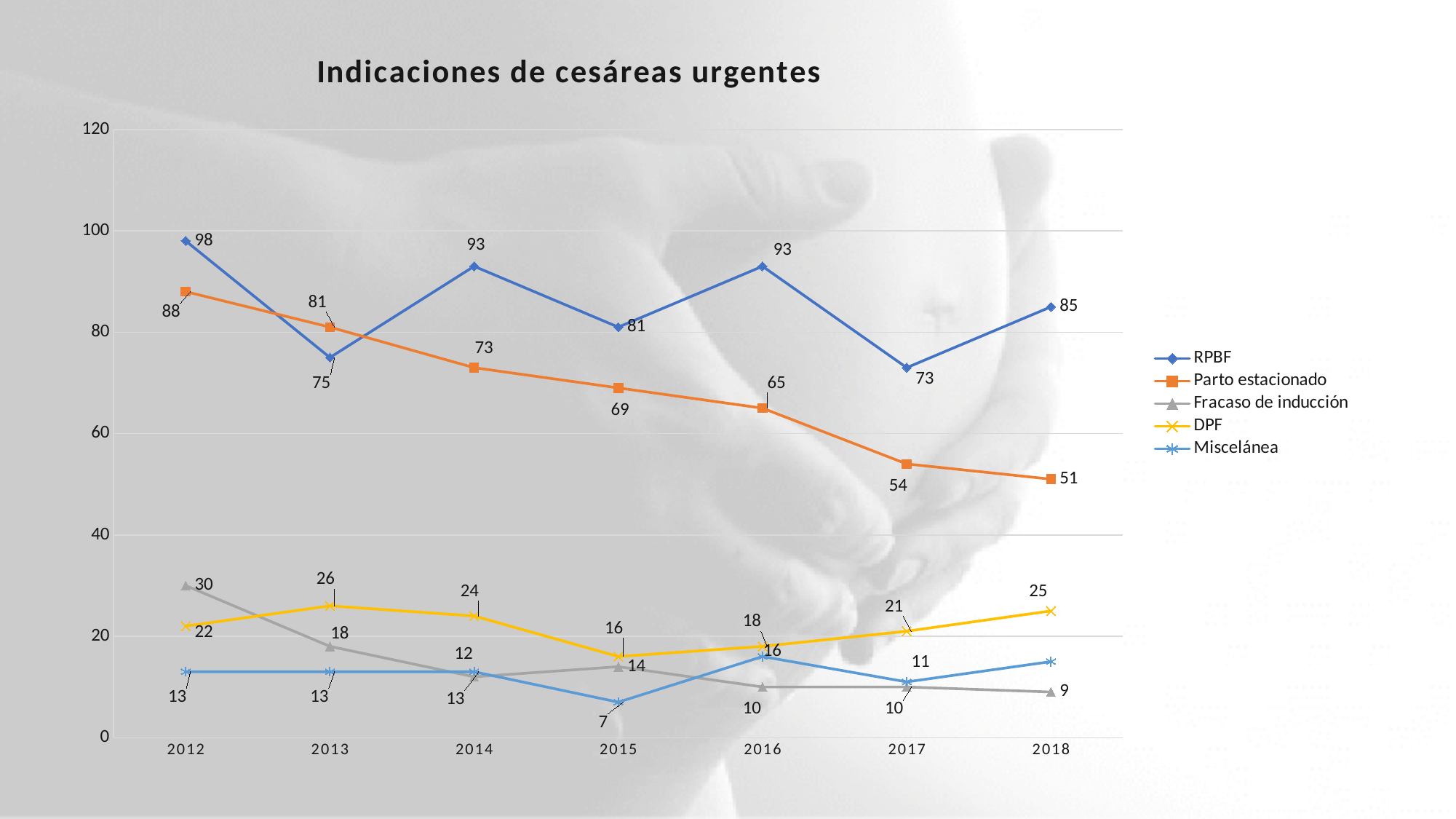
What is the difference between the RPBF values for 2012 and 2013? 23 In 2013, which is larger: RPBF or Parto estacionado? Parto estacionado Does the Parto estacionado series rise or fall from 2012 to 2018? Fall What is the value for Parto estacionado in 2018? 51 How many years are shown on the x axis? 7 How many series does the legend list? 5 In which year is the RPBF series at its highest? 2012 What kind of chart is shown on the slide? Line chart What is the value for Miscelánea in 2015? 7 In which year is the Parto estacionado series at its lowest? 2018 What is the value for RPBF in 2012? 98 What is the value for DPF in 2013? 26